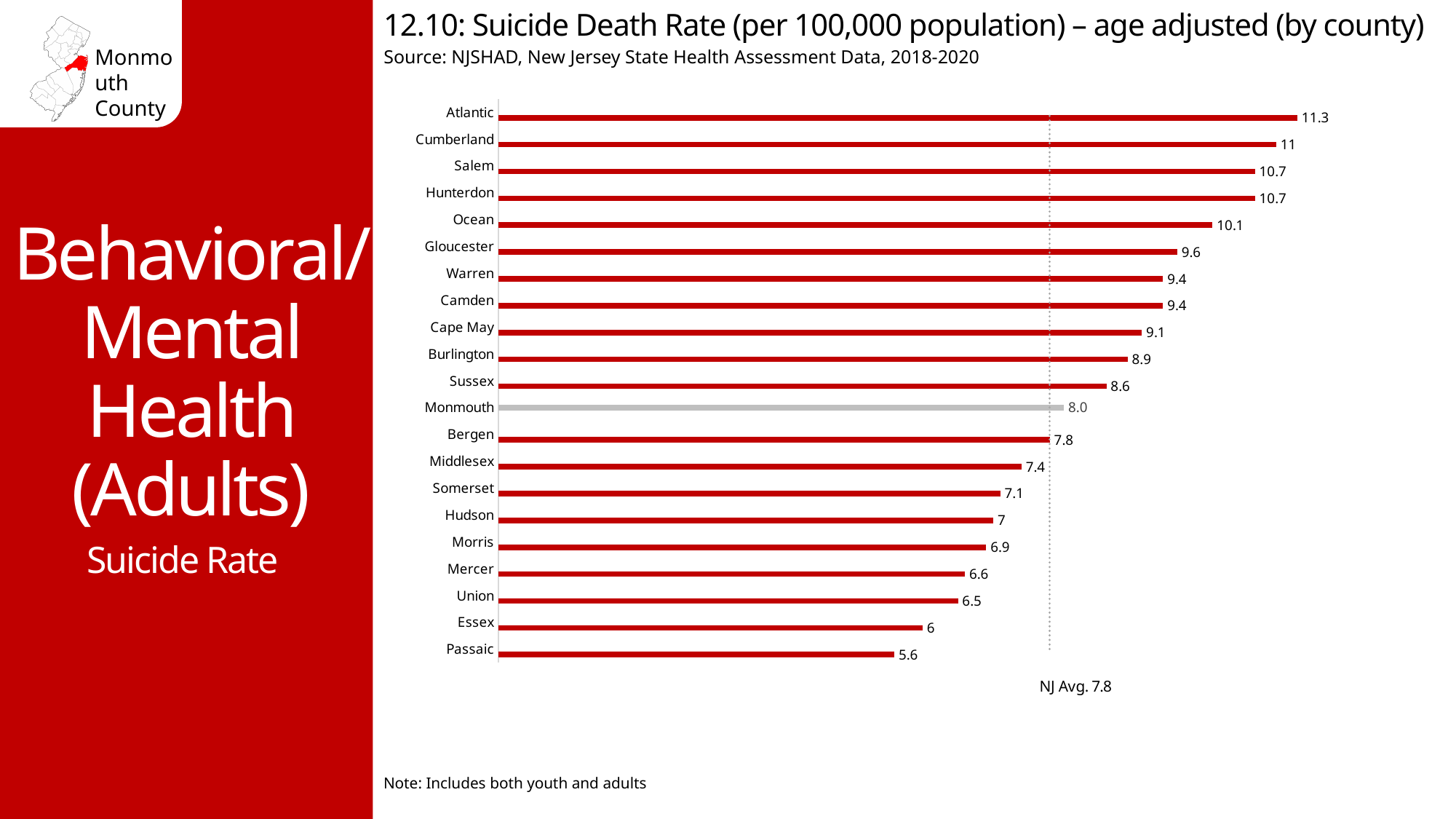
How many counties are shown in the chart? 21 Which has a higher suicide death rate, Ocean or Gloucester? Ocean What is the suicide death rate for Monmouth County? 8.0 What is the suicide death rate for Atlantic County? 11.3 What is the difference between Monmouth County's suicide death rate and the NJ average? 0.2 What is the difference between the suicide death rates of Atlantic and Passaic counties? 5.7 What type of chart is shown on the slide? Bar chart Which county's bar is shown in gray instead of red? Monmouth Which county has the lowest suicide death rate? Passaic Which county has the highest suicide death rate? Atlantic What is the NJ average suicide death rate shown on the chart? 7.8 What is the suicide death rate for Passaic County? 5.6